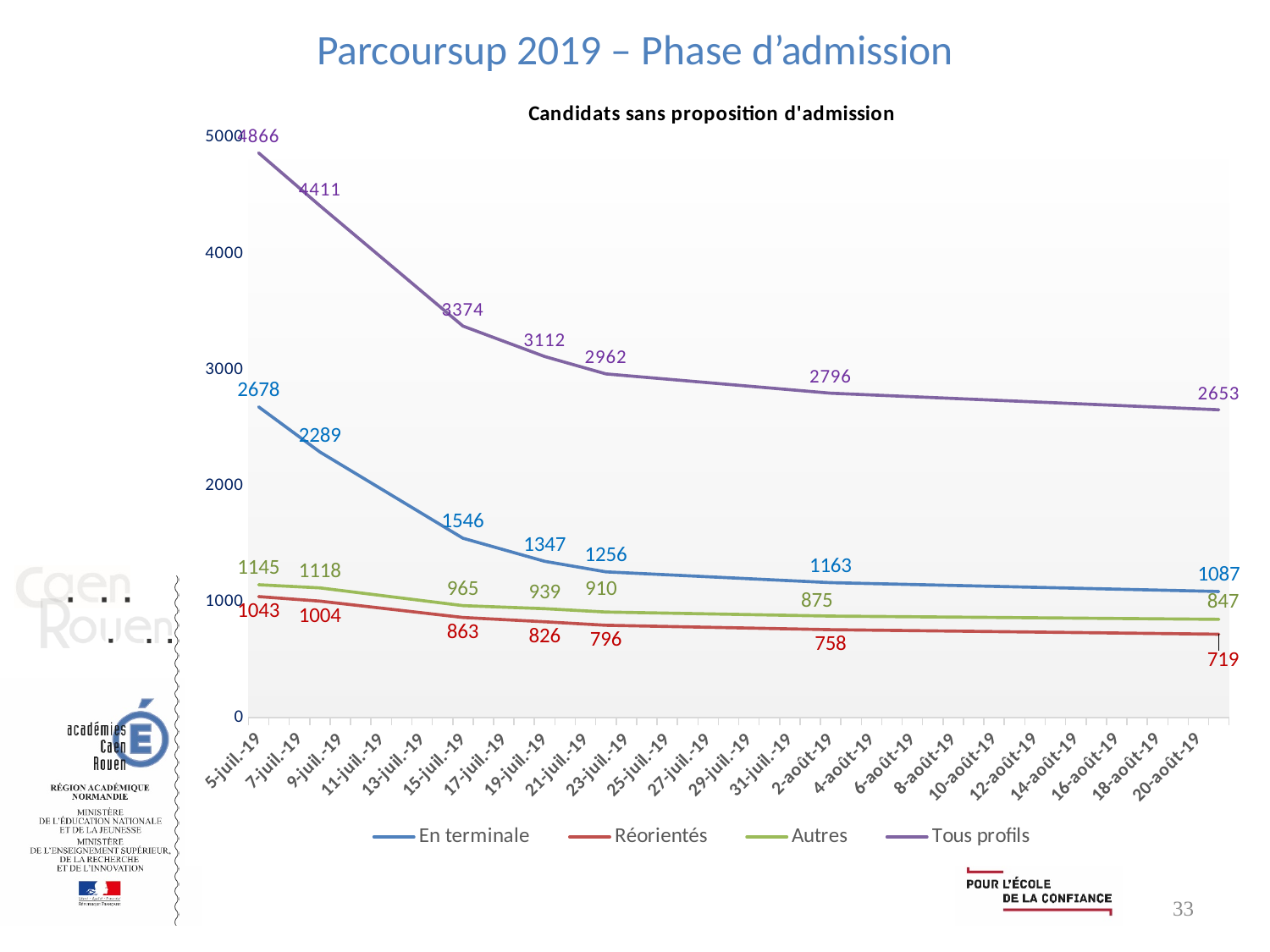
Does the Tous profils series rise or fall along the x axis? fall What kind of chart is shown on the slide? line chart What is the last labeled value of the Réorientés series (at 20-août-19)? 719 How many series does the legend list? 4 Which series has the highest values throughout the chart? Tous profils What is the last labeled value of the Autres series (at 20-août-19)? 847 What is the first labeled value of the En terminale series (at 5-juil.-19)? 2678 What is the first labeled value of the Tous profils series (at 5-juil.-19)? 4866 What is the last labeled value of the Tous profils series (at 20-août-19)? 2653 By how much does the Tous profils series fall between its first labeled value (4866) and its last labeled value (2653)? 2213 At the last point (20-août-19), which is larger: Autres or Réorientés? Autres What is the title of the chart? Candidats sans proposition d'admission